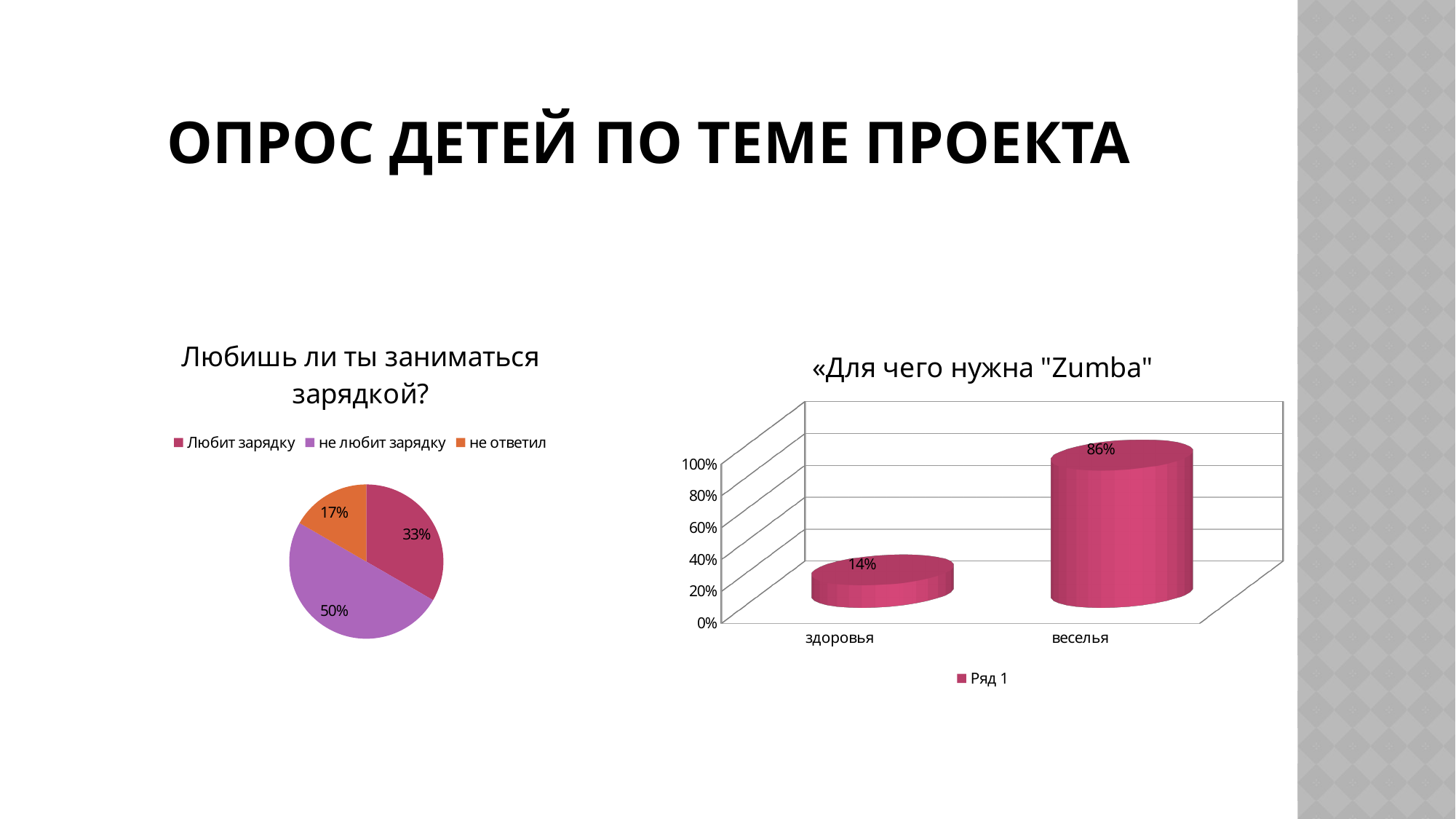
In the pie chart "Любишь ли ты заниматься зарядкой?", which category has the largest slice? не любит зарядку In the pie chart "Любишь ли ты заниматься зарядкой?", how many categories does the legend list? 3 In the chart "«Для чего нужна "Zumba"", what is the difference between "веселья" and "здоровья"? 72% In the pie chart "Любишь ли ты заниматься зарядкой?", which category has the smallest slice? не ответил In the pie chart "Любишь ли ты заниматься зарядкой?", what share is labelled for "Любит зарядку"? 33% In the chart "«Для чего нужна "Zumba"", which category has the higher value? веселья What kind of chart is the chart "«Для чего нужна "Zumba""? bar chart In the chart "«Для чего нужна "Zumba"", what is the value for "веселья"? 86% In the chart "«Для чего нужна "Zumba"", what is the value for "здоровья"? 14% In the pie chart "Любишь ли ты заниматься зарядкой?", what is the difference between the "не любит зарядку" and "Любит зарядку" shares? 17% In the pie chart "Любишь ли ты заниматься зарядкой?", what share is labelled for "не ответил"? 17% In the pie chart "Любишь ли ты заниматься зарядкой?", what share is labelled for "не любит зарядку"? 50%